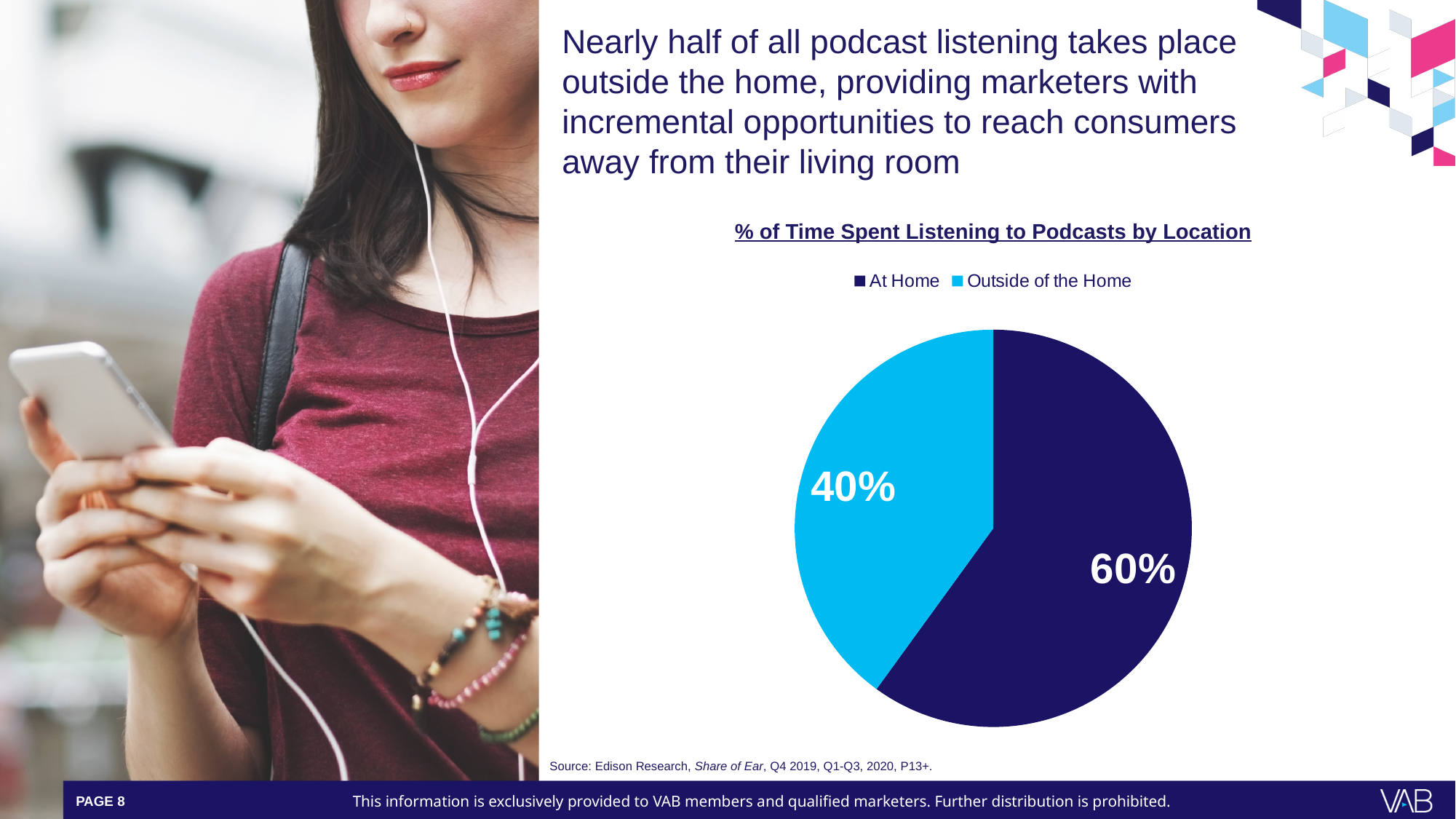
Which location accounts for the largest share of podcast listening time? At Home What share of the pie does the Outside of the Home slice represent? 40% What percentage of time spent listening to podcasts is At Home? 60% What is the difference in percentage points between At Home and Outside of the Home listening? 20 What type of chart is shown on the slide? Pie chart How many entries does the chart legend list? 2 Which location accounts for the smallest share of podcast listening time? Outside of the Home Which colour represents At Home in the pie chart? Dark navy blue What is the title of the chart? % of Time Spent Listening to Podcasts by Location Which is larger: the share for At Home or for Outside of the Home? At Home How many slices does the pie chart have? 2 What percentage of time spent listening to podcasts is Outside of the Home? 40%